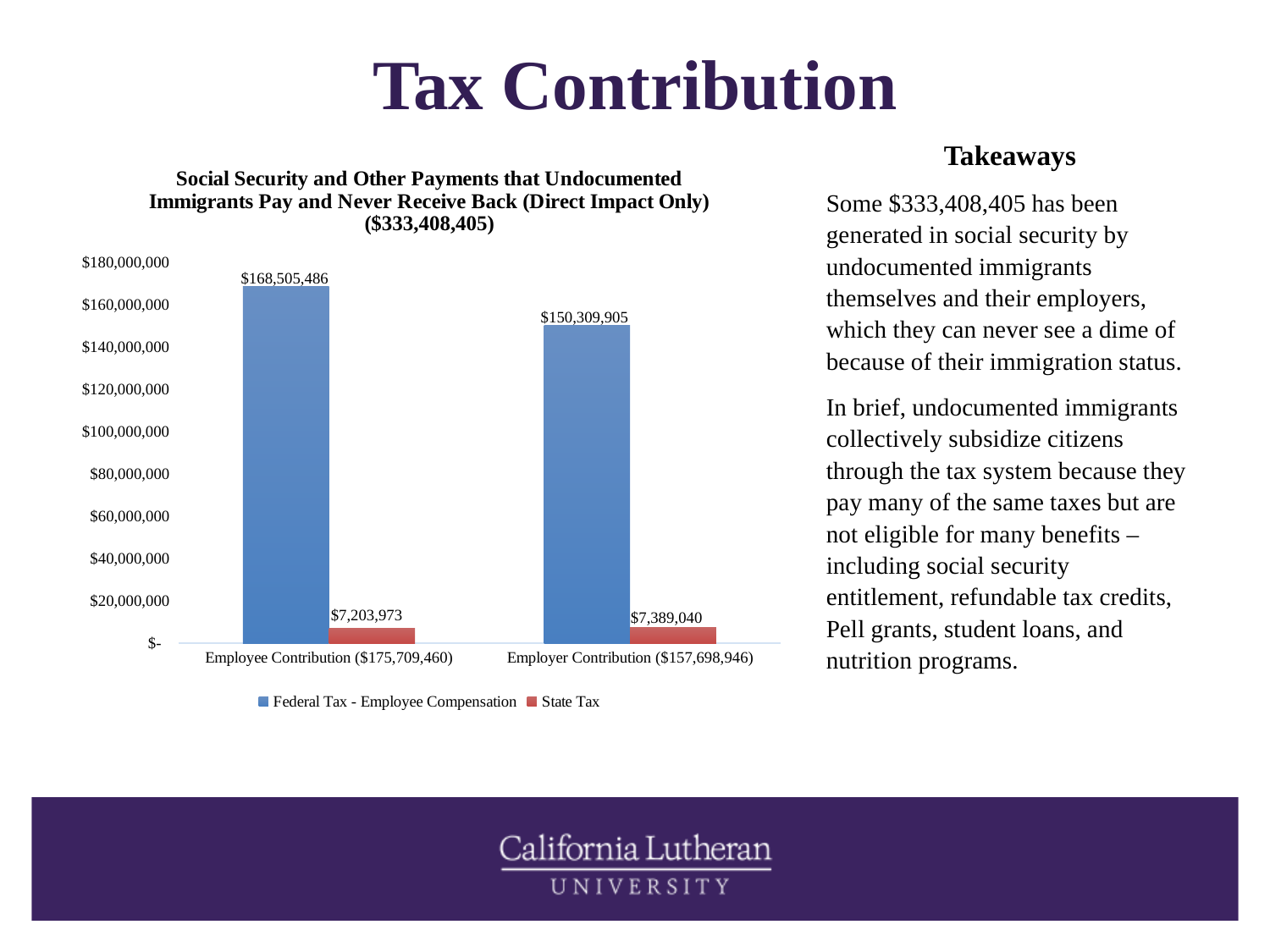
What type of chart is shown on the slide? Bar chart What is the difference between the Federal Tax - Employee Compensation values for Employee Contribution and Employer Contribution? $18,195,581 What is the difference between the State Tax values for Employer Contribution and Employee Contribution? $185,067 What is the State Tax value for Employee Contribution? $7,203,973 What is the Federal Tax - Employee Compensation value for Employee Contribution? $168,505,486 Is the State Tax value for Employer Contribution larger or smaller than the State Tax value for Employee Contribution? larger What is the Federal Tax - Employee Compensation value for Employer Contribution? $150,309,905 How many series does the legend list? 2 Is the Federal Tax - Employee Compensation value for Employer Contribution greater or less than $140,000,000? greater Which bar in the chart has the lowest value? State Tax for Employee Contribution What is the State Tax value for Employer Contribution? $7,389,040 Which category has the higher Federal Tax - Employee Compensation value? Employee Contribution